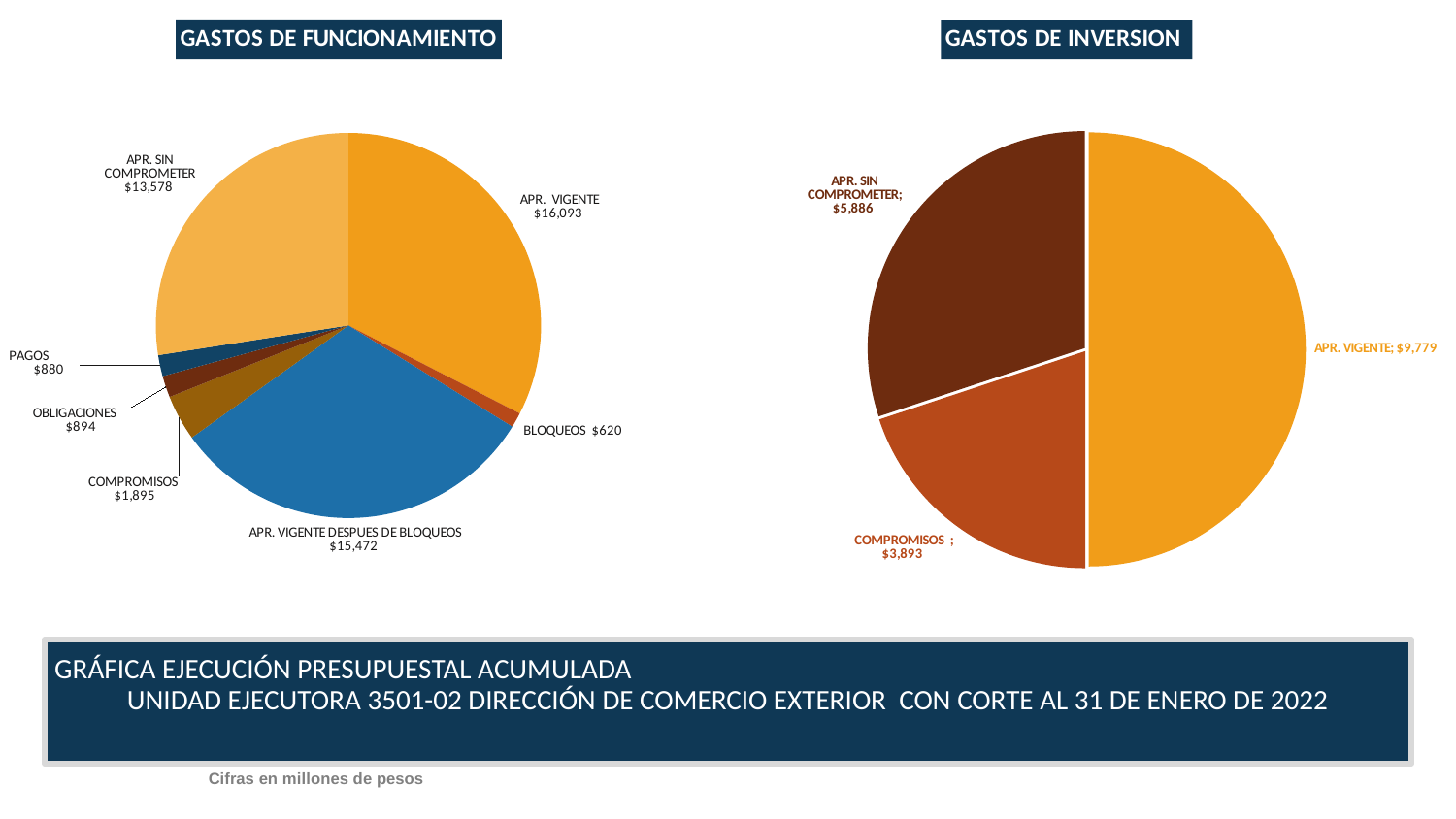
On the GASTOS DE INVERSION chart, what is the value for APR. SIN COMPROMETER? $5,886 On the GASTOS DE INVERSION chart, what share of the pie does APR. VIGENTE represent? 50% On the GASTOS DE INVERSION chart, what is the difference between APR. VIGENTE and COMPROMISOS? $5,886 On the GASTOS DE FUNCIONAMIENTO chart, how many slices does the pie have? 7 What type of chart is the GASTOS DE INVERSION chart? Pie chart On the GASTOS DE FUNCIONAMIENTO chart, what is the value for APR. VIGENTE DESPUES DE BLOQUEOS? $15,472 On the GASTOS DE FUNCIONAMIENTO chart, which is larger, COMPROMISOS or PAGOS? COMPROMISOS On the GASTOS DE INVERSION chart, what is the value for COMPROMISOS? $3,893 On the GASTOS DE FUNCIONAMIENTO chart, which category has the smallest value? BLOQUEOS On the GASTOS DE FUNCIONAMIENTO chart, what is the difference between COMPROMISOS and OBLIGACIONES? $1,001 On the GASTOS DE FUNCIONAMIENTO chart, what is the value for APR. VIGENTE? $16,093 On the GASTOS DE FUNCIONAMIENTO chart, which category has the largest value? APR. VIGENTE